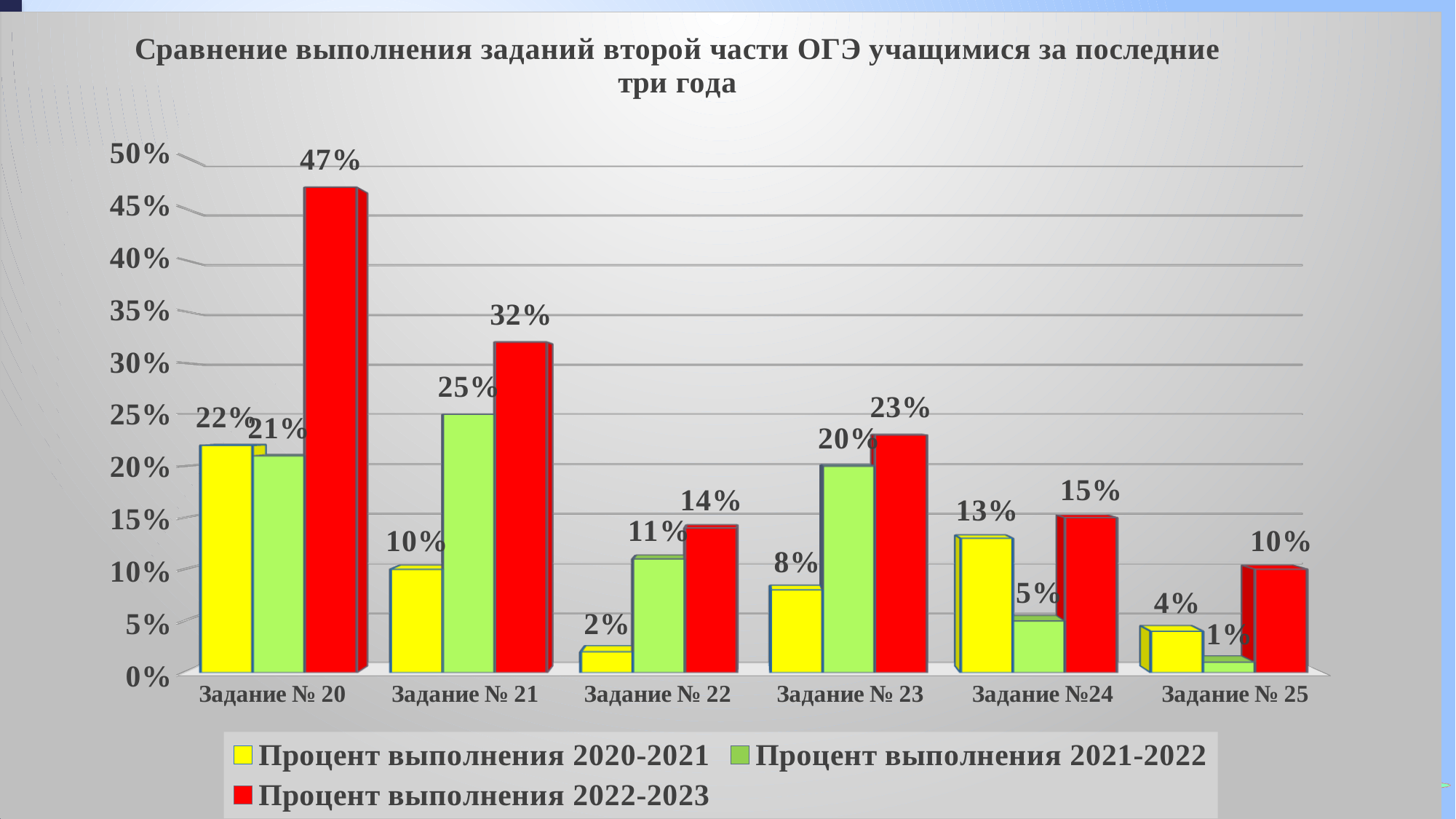
How many categories (tasks) are shown on the x axis? 6 Which category has the lowest value in the series Процент выполнения 2021-2022? Задание № 25 Which colour represents the series Процент выполнения 2022-2023? Red What is the difference between the 2022-2023 and 2020-2021 values for Задание № 21? 22% What is the value for Задание № 22 in the series Процент выполнения 2020-2021? 2% Which category has the highest value in the series Процент выполнения 2022-2023? Задание № 20 What is the difference between the 2022-2023 and 2021-2022 values for Задание № 23? 3% For Задание №24, which is larger: the value for Процент выполнения 2020-2021 or Процент выполнения 2021-2022? Процент выполнения 2020-2021 How many series does the legend list? 3 What is the value for Задание № 21 in the series Процент выполнения 2021-2022? 25% What kind of chart is shown on the slide? Bar chart What is the value for Задание № 20 in the series Процент выполнения 2022-2023? 47%